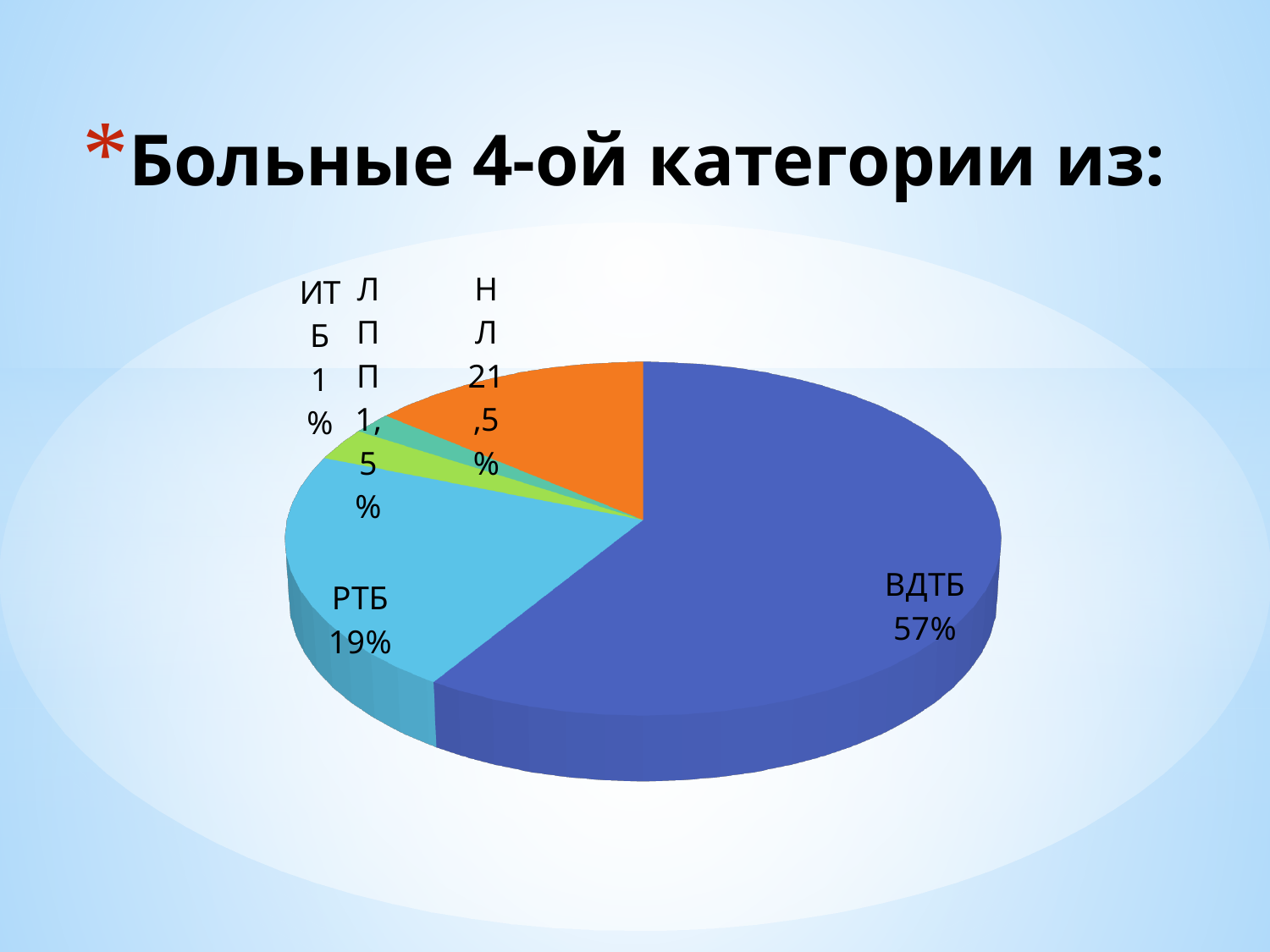
Which category has the largest slice of the pie? ВДТБ What share of the pie does НЛ have? 21,5% What kind of chart is shown on the slide? pie chart What is the difference between the shares of ВДТБ and РТБ? 38% What share of the pie does ИТБ have? 1% What is the title of the chart on the slide? Больные 4-ой категории из: What share of the pie does ВДТБ have? 57% What share of the pie does ЛПП have? 1,5% How many slices does the pie chart have? 5 What share of the pie does РТБ have? 19%